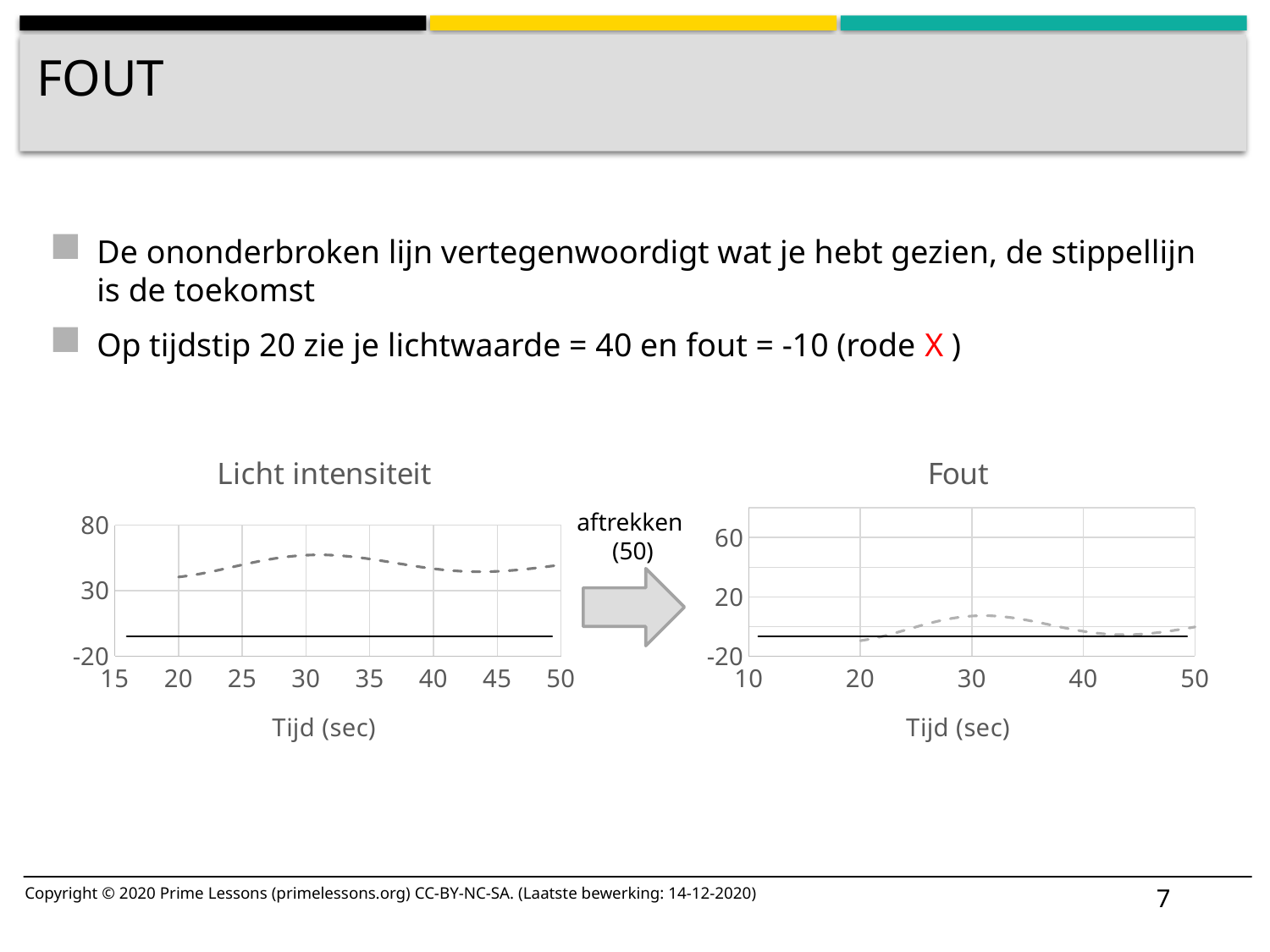
In the 'Fout' chart, is the dashed line's value at time 20 greater or less than 20? less In the 'Fout' chart, does the dashed line rise or fall between time 20 and time 30? rise How many tick labels are shown on the x axis of the 'Fout' chart? 5 What kind of chart is the 'Fout' chart? line chart What kind of chart is the 'Licht intensiteit' chart? line chart In the 'Licht intensiteit' chart, does the dashed line rise or fall between time 20 and time 30? rise What is the x-axis title of the 'Fout' chart? Tijd (sec) In the 'Fout' chart, is the dashed line's value at time 30 greater or less than 20? less In the 'Licht intensiteit' chart, is the dashed line's value at time 20 greater or less than 30? greater In the 'Licht intensiteit' chart, does the dashed line rise or fall between time 30 and time 40? fall